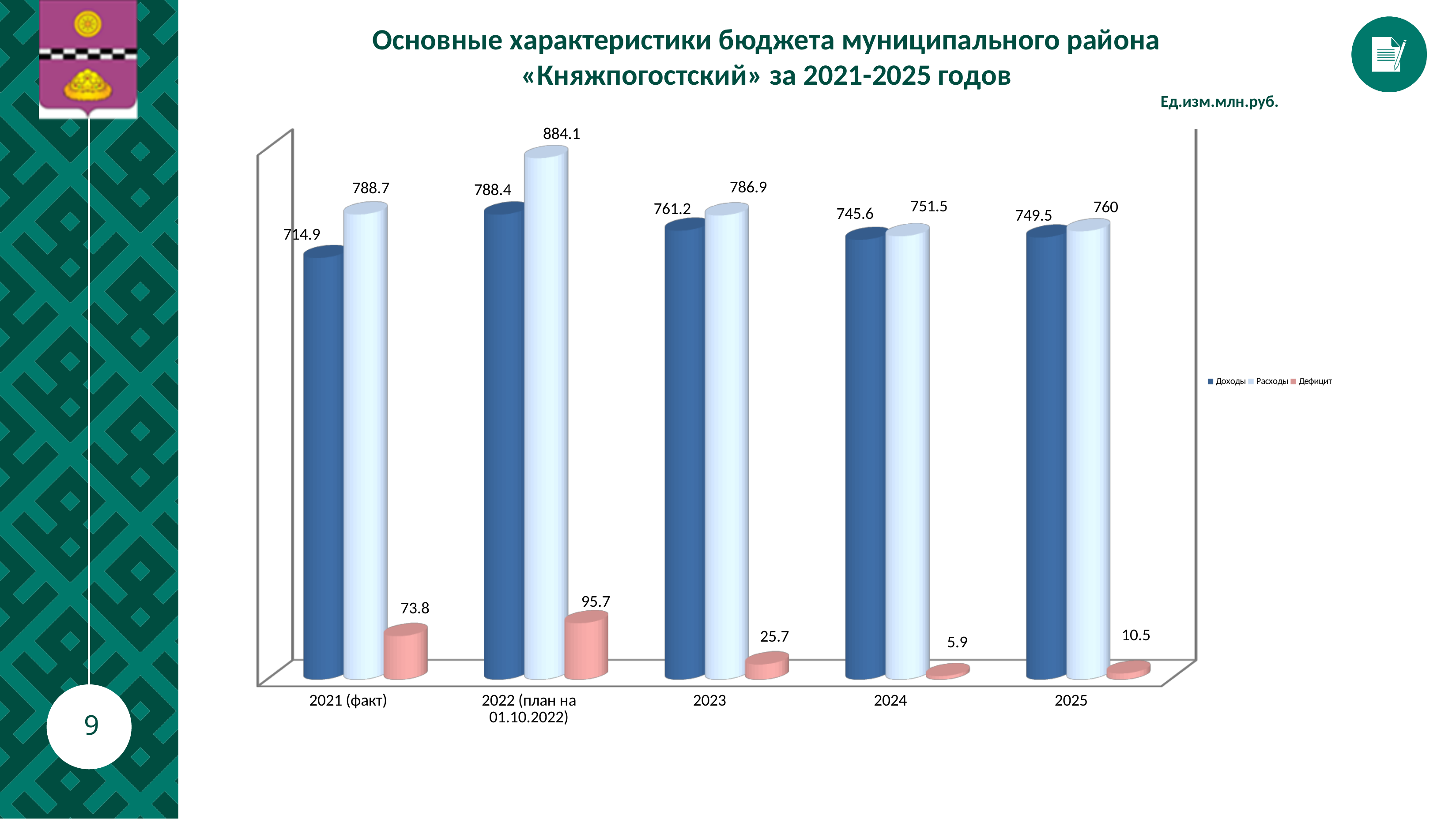
What kind of chart is shown on the slide? Bar chart What is the value of Расходы for 2022 (план на 01.10.2022)? 884.1 What is the difference between Расходы and Доходы for 2023? 25.7 How many series does the legend list? 3 What is the value of Дефицит for 2024? 5.9 What is the value of Расходы for 2025? 760 In which year is Расходы highest? 2022 (план на 01.10.2022) What is the value of Доходы for 2021 (факт)? 714.9 In which year is Дефицит lowest? 2024 What unit of measurement is stated for the chart values? млн.руб. How many years (categories) are shown on the x axis? 5 Which is larger for 2021 (факт): Доходы or Расходы? Расходы